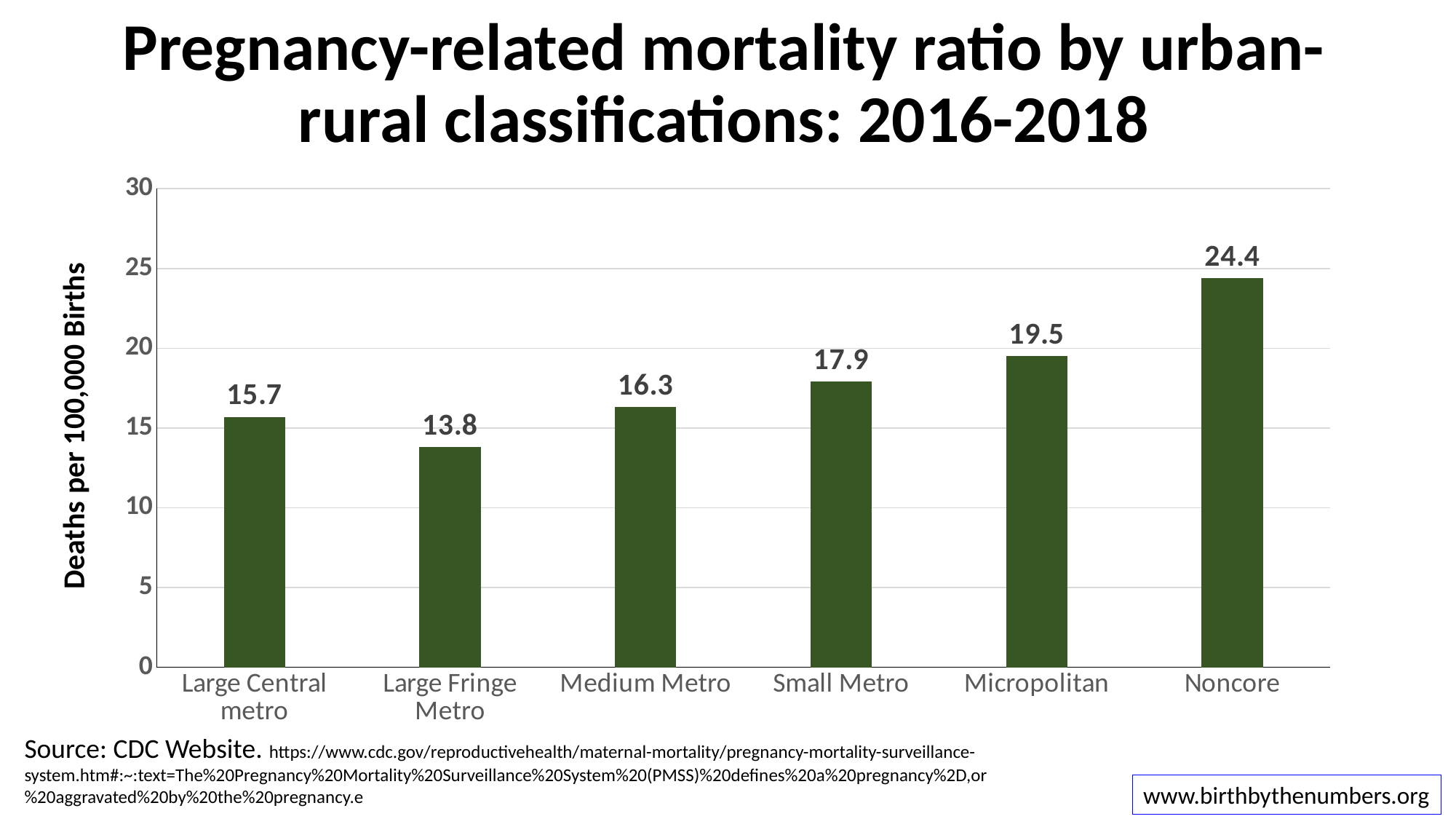
How many urban-rural classifications are shown on the chart? 6 What is the value shown for Small Metro? 17.9 Which urban-rural classification has the highest mortality ratio? Noncore What is the difference between the values for Micropolitan and Medium Metro? 3.2 Which urban-rural classification has the lowest mortality ratio? Large Fringe Metro What kind of chart is shown on the slide? bar chart What is the difference between the values for Noncore and Large Central metro? 8.7 Is the value for Micropolitan greater or less than 20? less What is the pregnancy-related mortality ratio for Noncore areas? 24.4 Which has a higher mortality ratio, Large Central metro or Medium Metro? Medium Metro What is the value shown for Large Fringe Metro? 13.8 What is the label on the vertical axis of the chart? Deaths per 100,000 Births